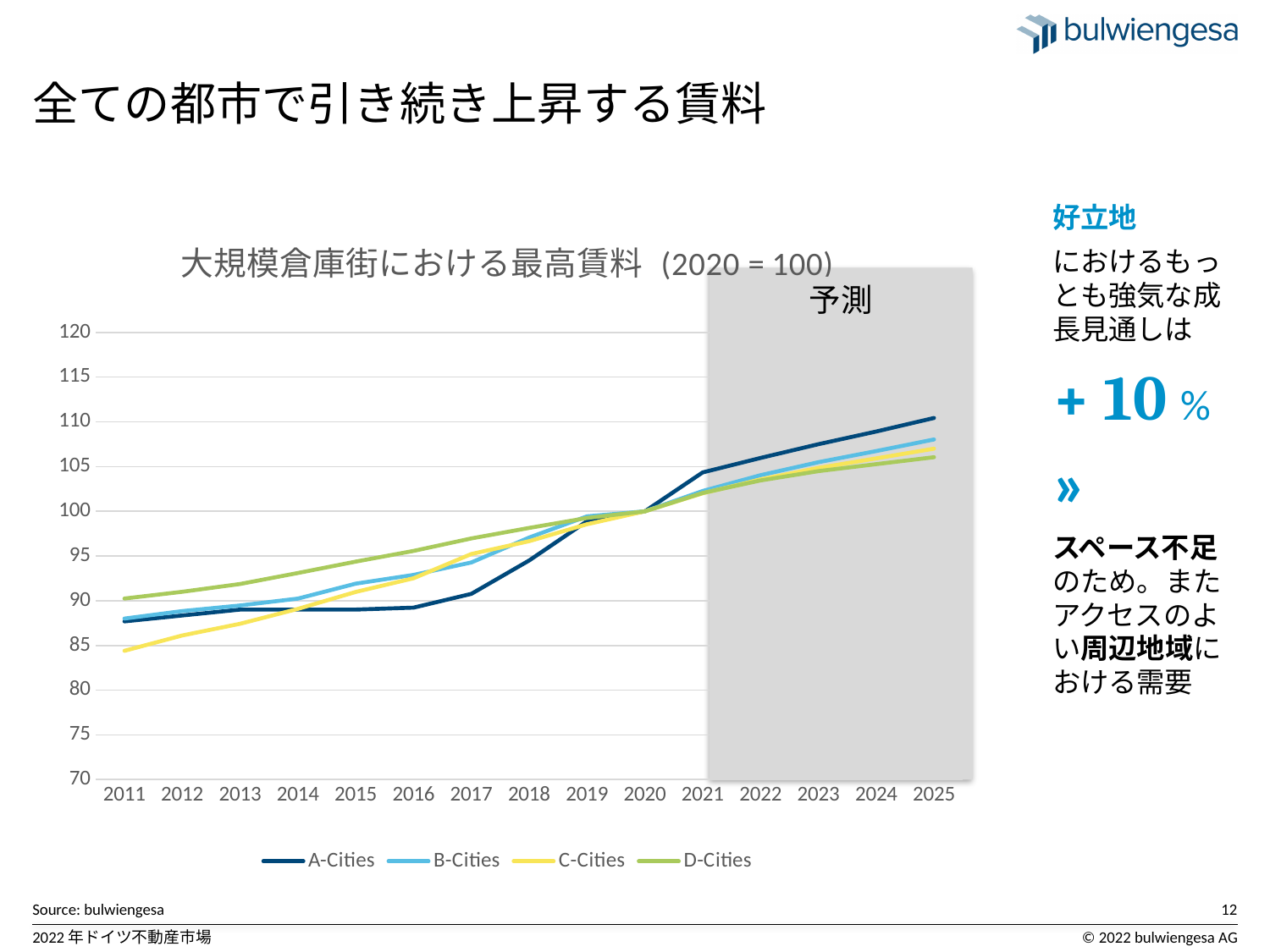
What is the index value for all series in 2020? 100 Which series has the highest value in 2011? D-Cities How many years are shown along the x axis? 15 How many series does the legend list? 4 Do the values for A-Cities rise or fall from 2011 to 2025? rise Is the value for C-Cities in 2011 greater or less than 90? less What kind of chart is shown on the slide? line chart In 2025, which is larger: A-Cities or D-Cities? A-Cities Is the value for A-Cities in 2025 greater or less than 105? greater Which series has the highest value in 2025? A-Cities Which years are covered by the shaded forecast (予測) area? 2021 to 2025 Which series has the lowest value in 2011? C-Cities